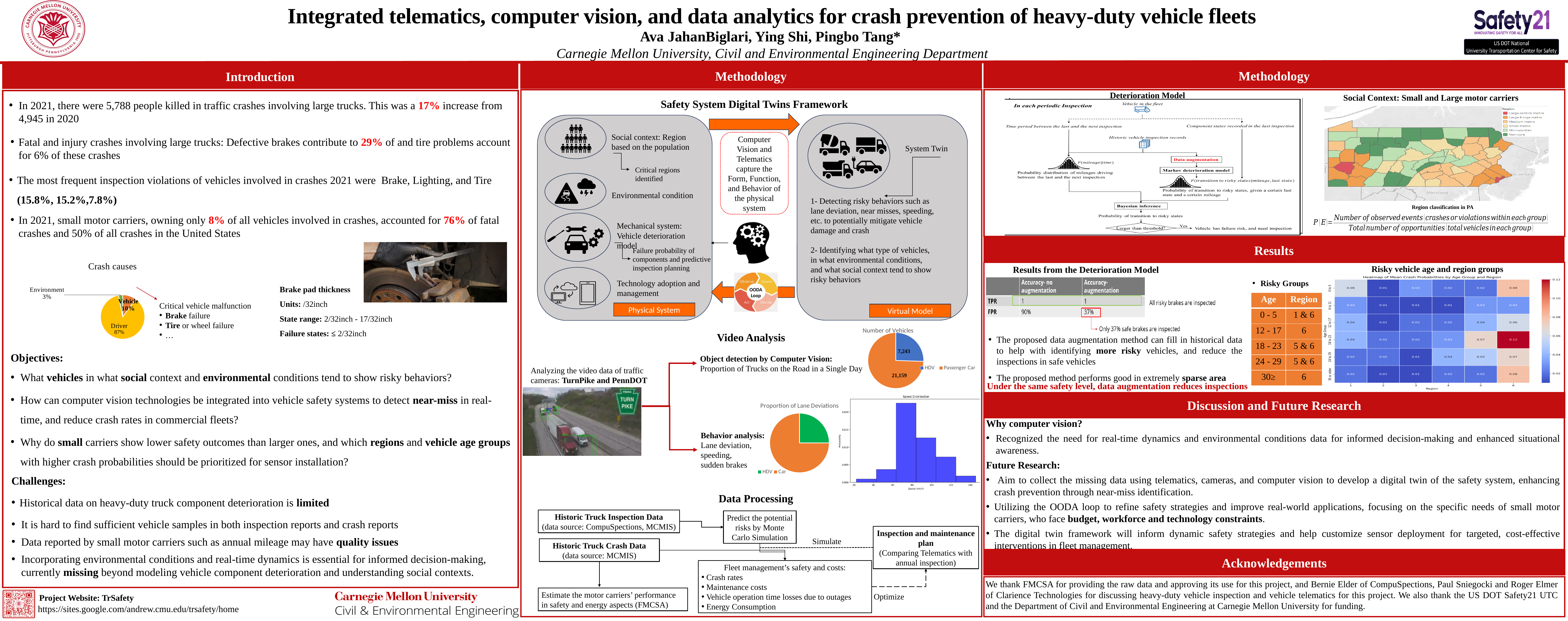
In the 'Number of Vehicles' pie chart, how many entries does the legend list? 2 In the 'Crash causes' pie chart, what percentage is attributed to Driver? 87% In the 'Crash causes' pie chart, what percentage is attributed to Environment? 3% In the 'Crash causes' pie chart, how many slices are there? 3 In the 'Crash causes' pie chart, what percentage is attributed to Vehicle? 10% In the 'Proportion of Lane Deviations' pie chart, which category has the larger share, HDV or Car? Car In the 'Number of Vehicles' pie chart, what is the value for Passenger Car? 21,159 In the 'Number of Vehicles' pie chart, what is the value for HDV? 7,243 In the 'Crash causes' pie chart, which cause has the smallest share? Environment In the 'Crash causes' pie chart, which cause has the largest share? Driver In the 'Number of Vehicles' pie chart, what is the total number of vehicles across both categories? 28,402 In the 'Crash causes' pie chart, what is the difference between the Driver share and the Vehicle share? 77%